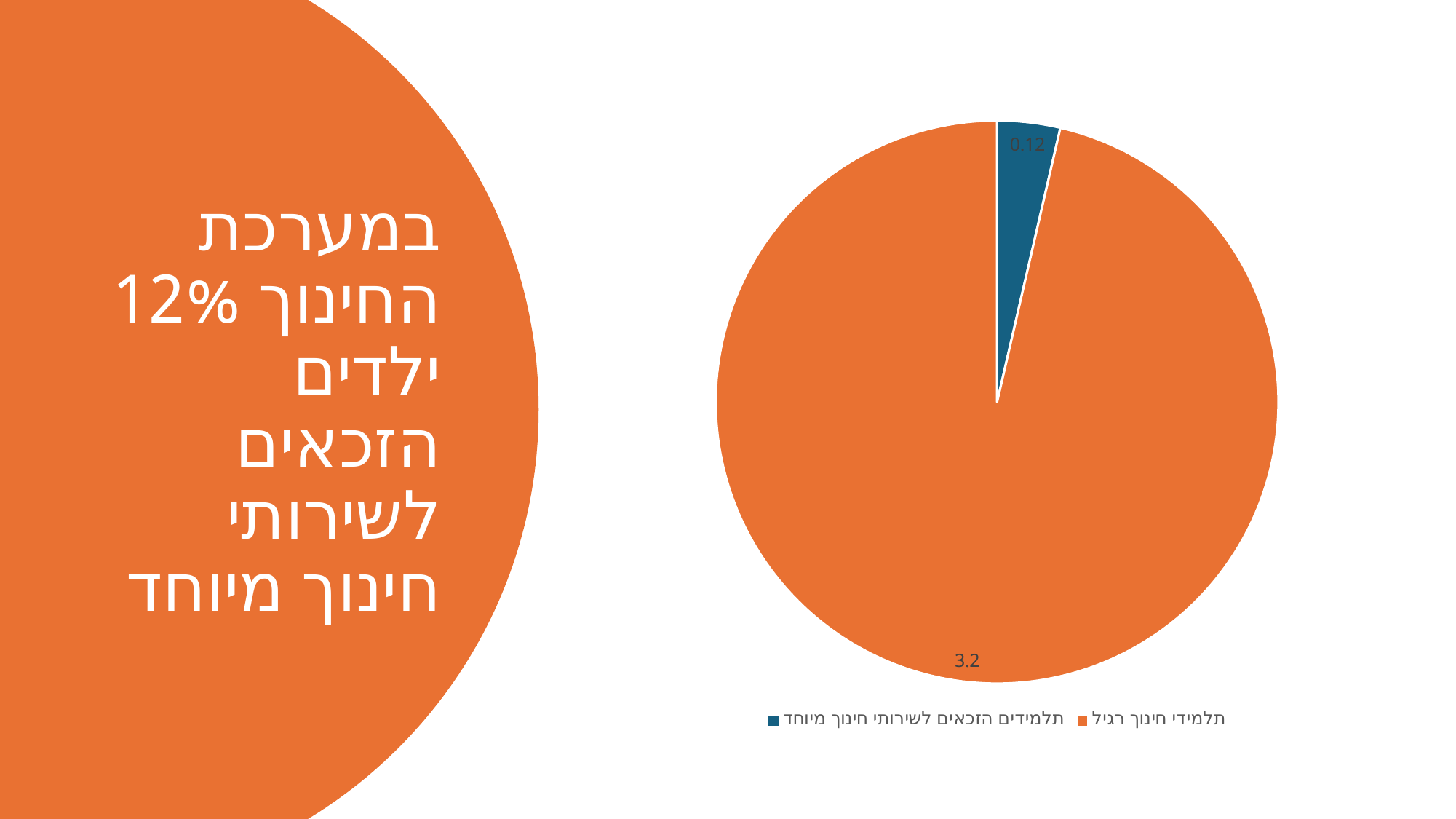
What kind of chart is shown on the slide? pie chart What is the difference between the value for תלמידי חינוך רגיל and the value for תלמידים הזכאים לשירותי חינוך מיוחד? 3.08 What is the value shown for the slice תלמידי חינוך רגיל? 3.2 How many slices does the pie chart have? 2 What is the value shown for the slice תלמידים הזכאים לשירותי חינוך מיוחד? 0.12 What colour is the slice for תלמידי חינוך רגיל? orange What colour is the slice for תלמידים הזכאים לשירותי חינוך מיוחד? blue Which slice of the pie chart is the smallest? תלמידים הזכאים לשירותי חינוך מיוחד How many entries does the legend of the pie chart list? 2 What is the total of the two values shown in the pie chart? 3.32 Which slice of the pie chart is the largest? תלמידי חינוך רגיל Which is larger: the value for תלמידי חינוך רגיל or the value for תלמידים הזכאים לשירותי חינוך מיוחד? תלמידי חינוך רגיל